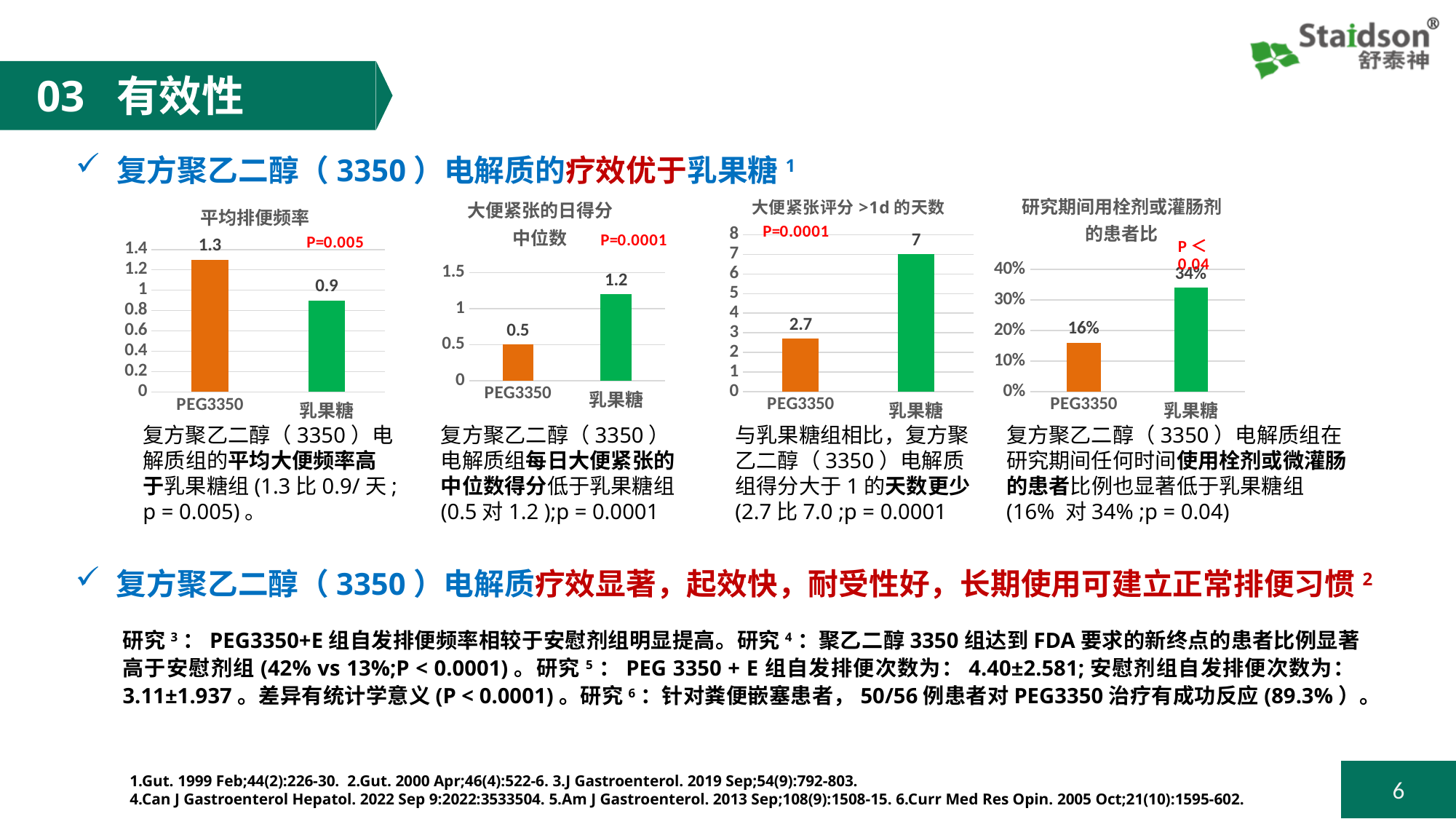
In the chart titled 平均排便频率, what is the value for PEG3350? 1.3 In the chart titled 平均排便频率, what is the value for 乳果糖? 0.9 In the chart titled 大便紧张评分>1d的天数, which category has the lowest value? PEG3350 In the chart titled 研究期间用栓剂或灌肠剂的患者比, is the value for 乳果糖 greater or less than 30%? greater In the chart titled 大便紧张的日得分中位数, what is the difference between the 乳果糖 value and the PEG3350 value? 0.7 What type of chart is the chart titled 平均排便频率? bar chart In the chart titled 大便紧张评分>1d的天数, what is the difference between the 乳果糖 value and the PEG3350 value? 4.3 In the chart titled 平均排便频率, which category has the higher value? PEG3350 How many bar charts are shown on the slide? 4 In the chart titled 研究期间用栓剂或灌肠剂的患者比, what is the value for PEG3350? 16% In the chart titled 大便紧张的日得分中位数, what is the value for PEG3350? 0.5 In the chart titled 大便紧张评分>1d的天数, what is the value for 乳果糖? 7